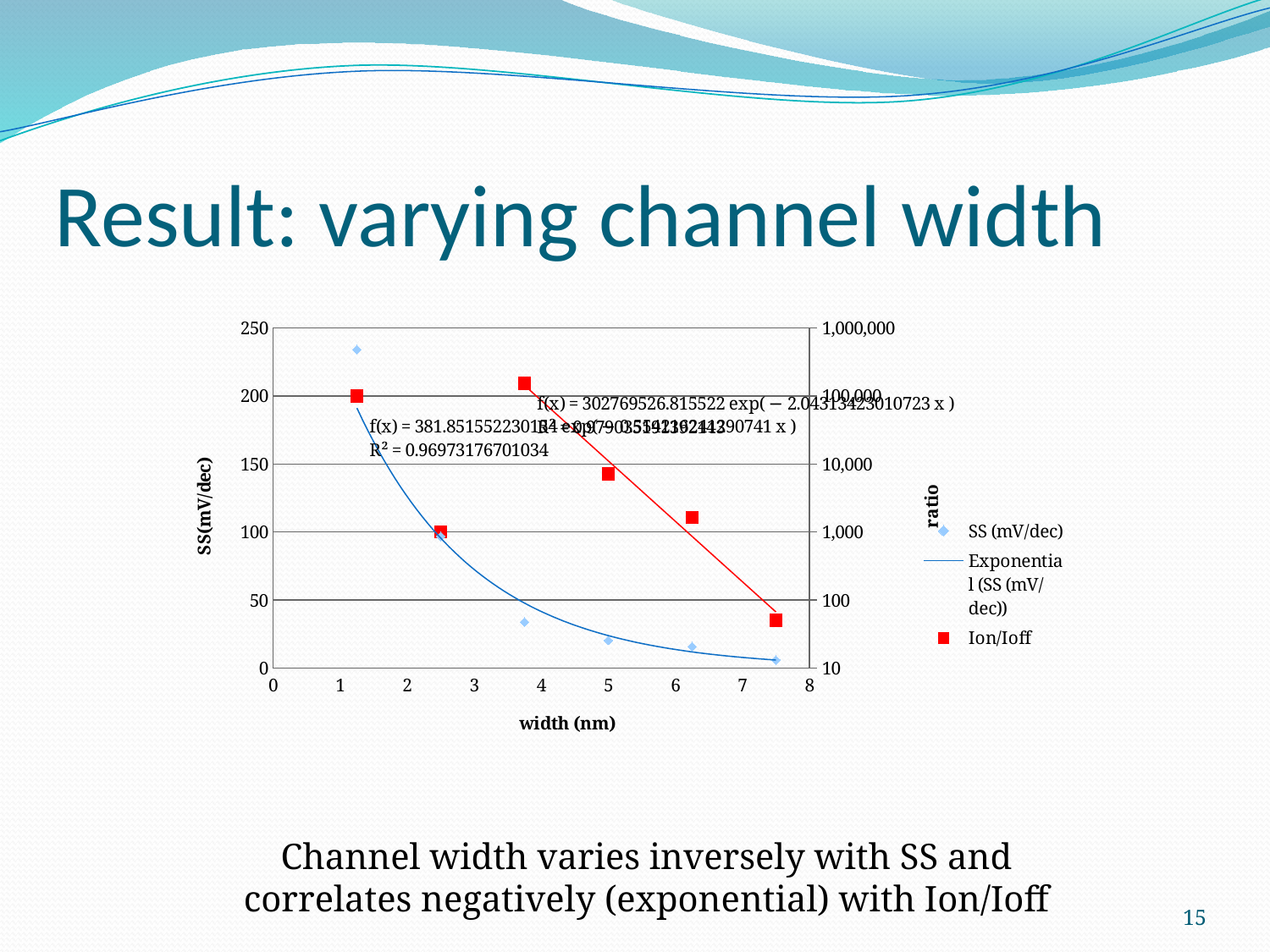
Is the SS (mV/dec) value at the smallest plotted width greater or less than 200? greater Is the SS (mV/dec) value at the largest plotted width greater or less than 50? less Is the Ion/Ioff value at a width of 5 nm greater or less than 1,000? greater How many series does the chart legend list? 3 How many Ion/Ioff data points are plotted on the chart? 6 Does the SS (mV/dec) value rise or fall as channel width increases? fall Which series is plotted against the right-hand 'ratio' axis? Ion/Ioff What kind of chart is shown on the slide? scatter chart What is the title of the x axis of the chart? width (nm) How many SS (mV/dec) data points are plotted on the chart? 6 Does the Ion/Ioff ratio generally rise or fall as channel width increases? fall